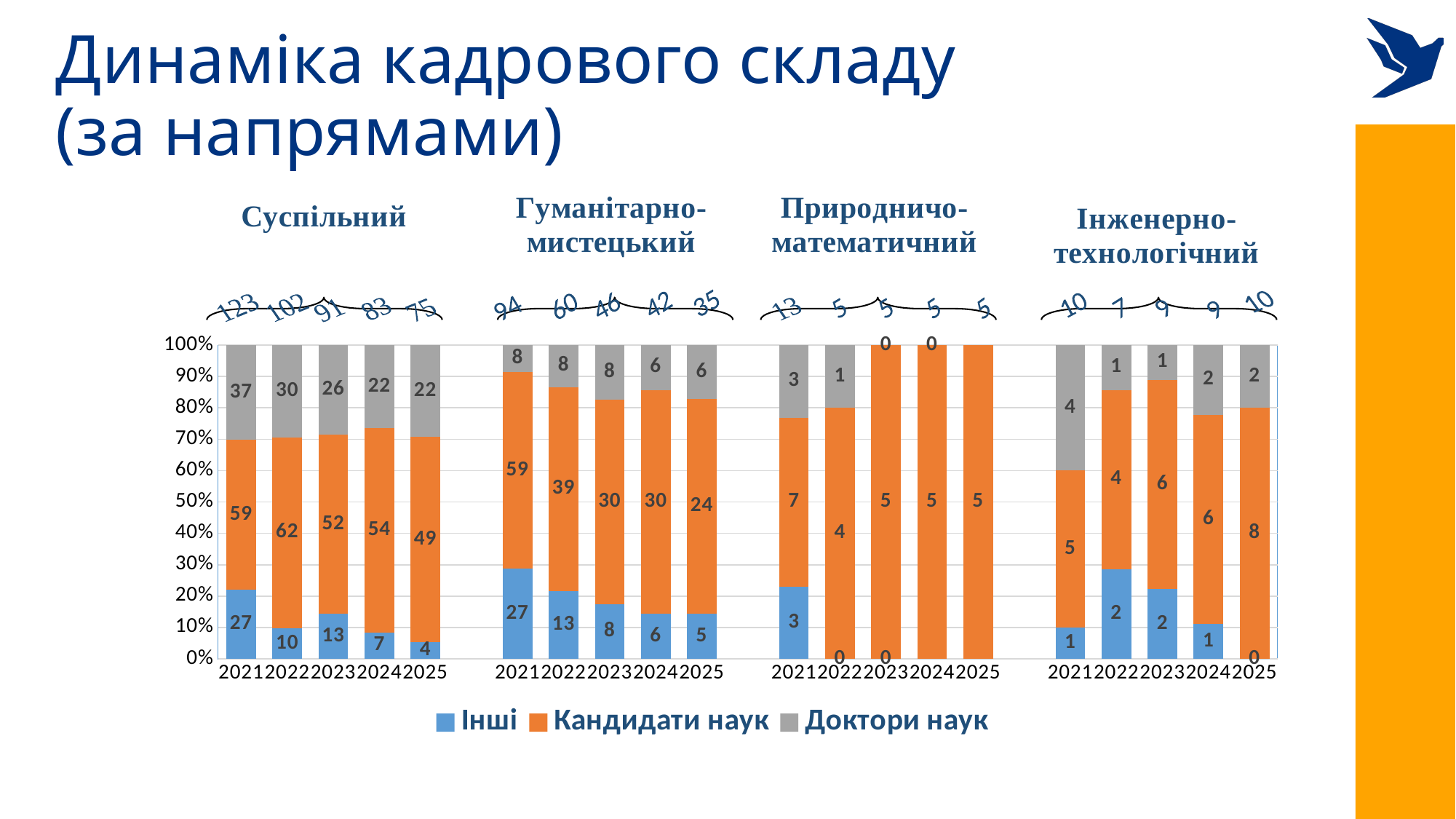
Does the Кандидати наук value in the Гуманітарно-мистецький group rise or fall from 2021 to 2025? Fall What is the value for Кандидати наук in the Суспільний group in 2022? 62 What is the total of the stacked bar for 2021 in the Природничо-математичний group? 13 In which year is the Інші value highest in the Суспільний group? 2021 In which year is the Кандидати наук value lowest in the Гуманітарно-мистецький group? 2025 What is the value for Доктори наук in the Гуманітарно-мистецький group in 2021? 8 Which is larger in 2023: Кандидати наук in the Суспільний group or Кандидати наук in the Гуманітарно-мистецький group? Суспільний What is the value for Інші in the Інженерно-технологічний group in 2025? 0 What is the difference between the Доктори наук values for 2021 and 2025 in the Суспільний group? 15 What kind of chart is shown on the slide? Stacked bar chart How many years are shown for each group on the x axis? 5 How many series does the legend list? 3